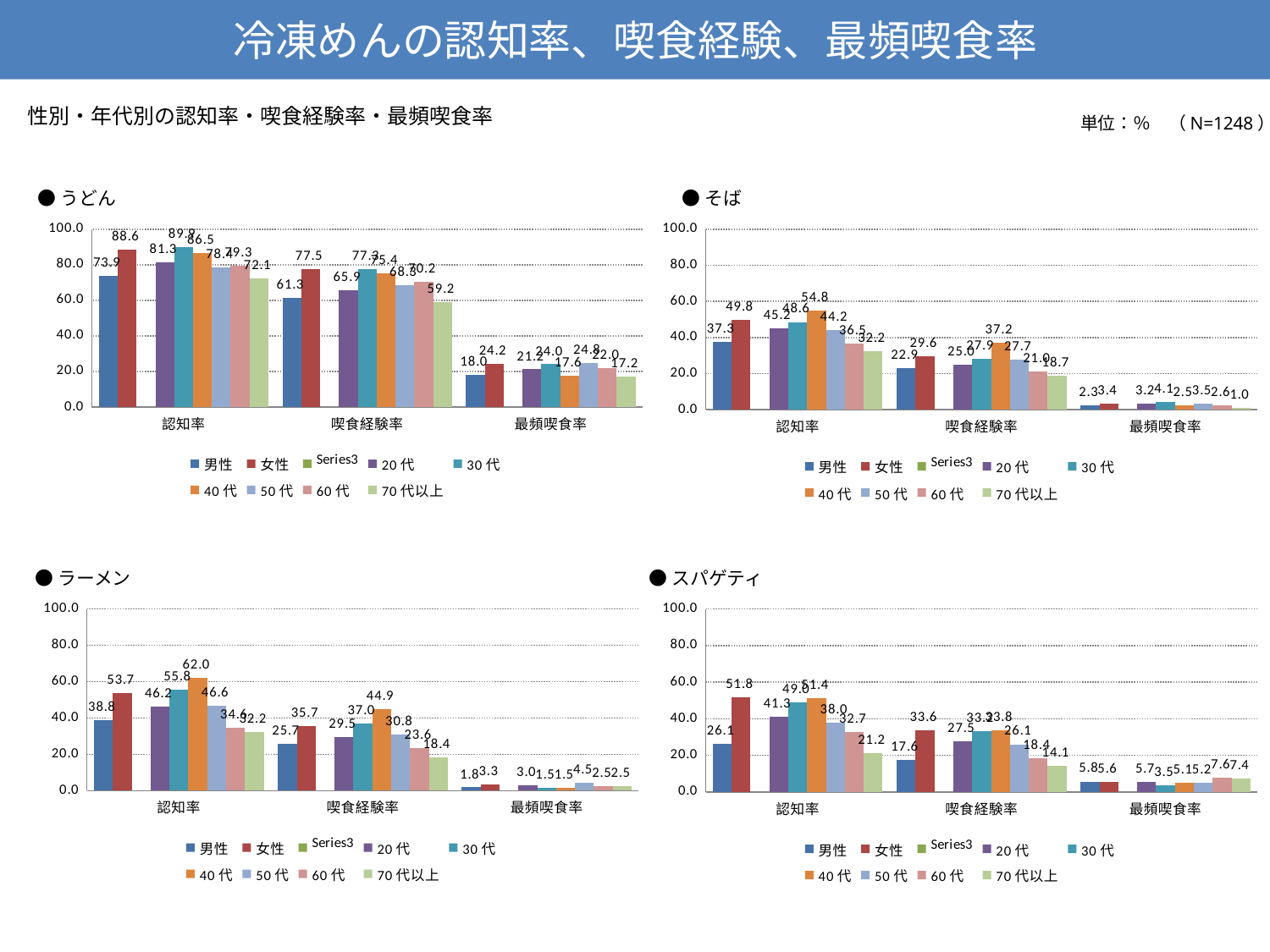
In the スパゲティ chart, what is the 喫食経験率 value for 男性? 17.6 In the うどん chart, is the 認知率 value for 男性 greater or less than 60.0? greater How many series does the legend of the そば chart list? 9 In the うどん chart, what is the 喫食経験率 value for 70代以上? 59.2 What kind of chart is the スパゲティ chart? bar chart In the ラーメン chart, what is the difference between the 認知率 for 40代 and for 男性? 23.2 In the そば chart, which series has the highest 認知率? 40代 In the うどん chart, what is the 認知率 value for 女性? 88.6 In the ラーメン chart, which series has the lowest 喫食経験率? 70代以上 In the スパゲティ chart, which is larger, the 認知率 for 男性 or for 女性? 女性 How many categories are shown on the x axis of the ラーメン chart? 3 In the そば chart, what is the 喫食経験率 value for 40代? 37.2